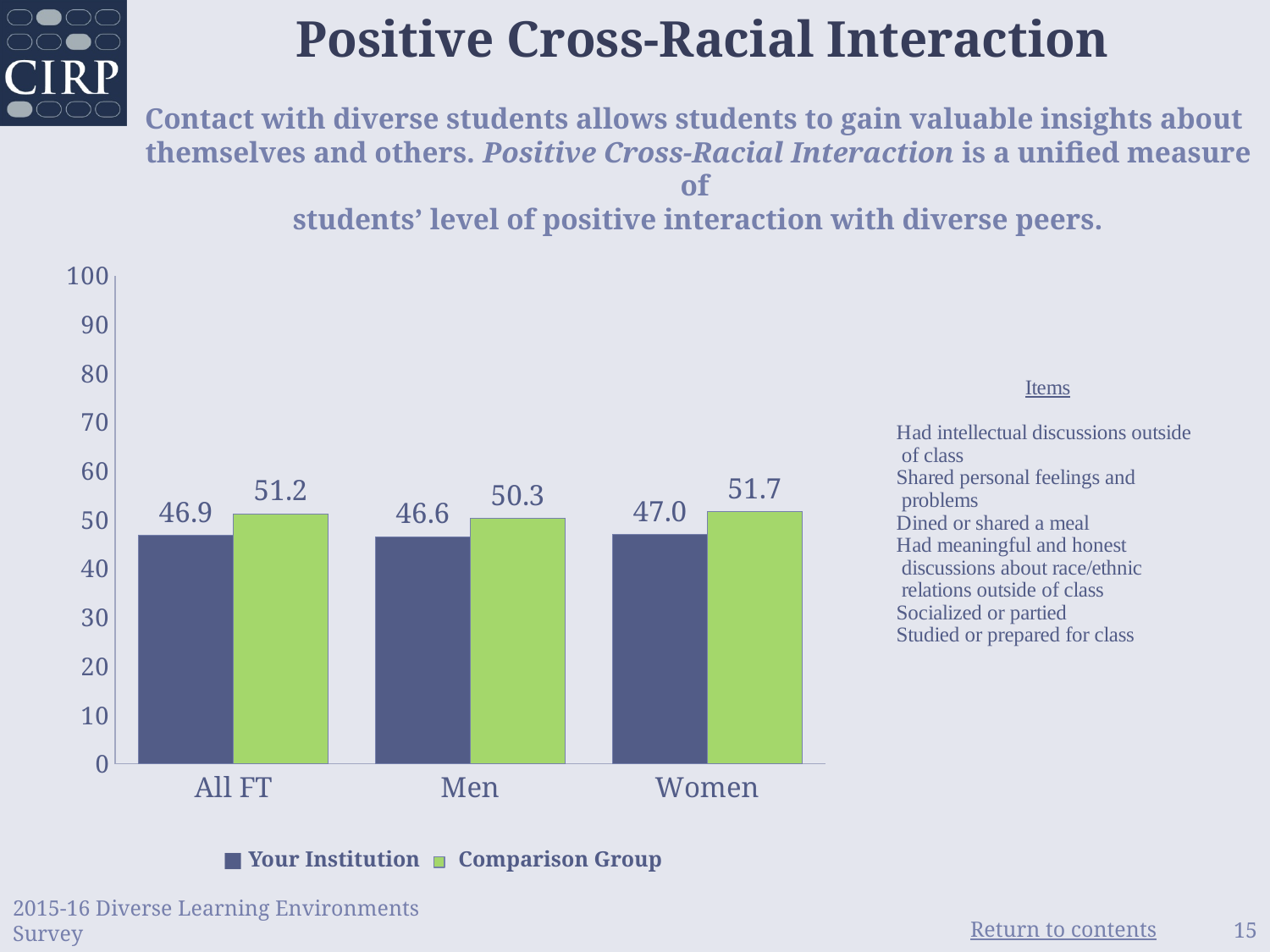
How many categories are shown on the x axis? 3 What is the title of the slide containing the chart? Positive Cross-Racial Interaction What is the value for Comparison Group in the Women category? 51.7 What is the value for Your Institution in the All FT category? 46.9 Which category has the highest Comparison Group value? Women What is the difference between the Comparison Group and Your Institution values for All FT? 4.3 Which is larger for Men: Your Institution or Comparison Group? Comparison Group What is the value for Your Institution in the Men category? 46.6 Is the value for Your Institution in the Women category greater or less than 50? less Which category has the lowest Your Institution value? Men What kind of chart is shown on the slide? bar chart How many series does the legend list? 2